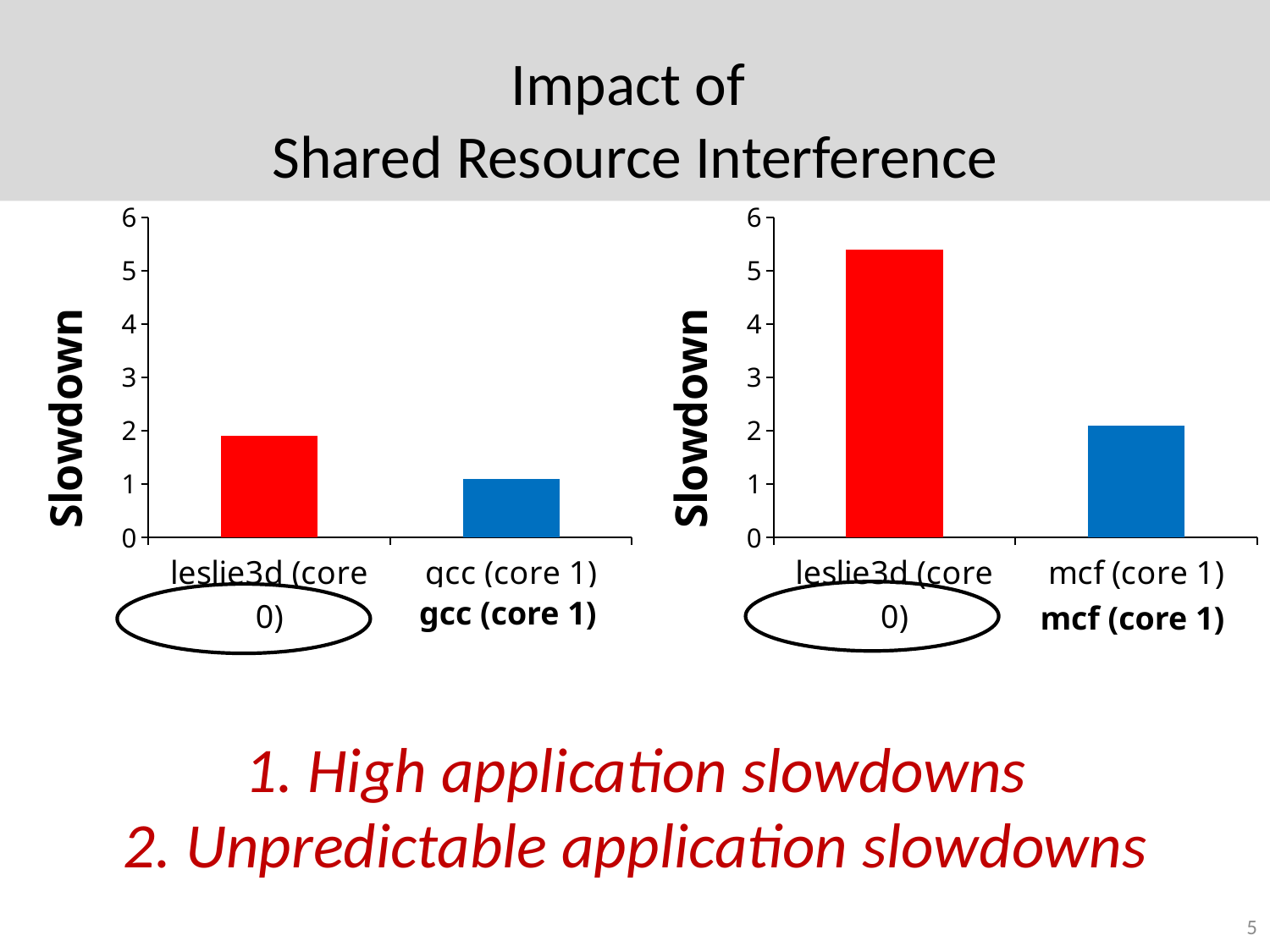
What is the y-axis label on the left chart? Slowdown Is the slowdown for leslie3d (core 0) larger on the left chart or on the right chart? right chart On the left chart, which category has the higher slowdown? leslie3d (core 0) How many categories are shown on the right chart? 2 On the right chart, which category has the higher slowdown? leslie3d (core 0) On the right chart, which category has the lower slowdown? mcf (core 1) On the left chart, which category has the lower slowdown? gcc (core 1) What kind of chart is the left chart? bar chart On the right chart, is the slowdown for leslie3d (core 0) greater or less than 5? greater On the right chart, is the slowdown for mcf (core 1) greater or less than 3? less On the left chart, is the slowdown for gcc (core 1) greater or less than 2? less